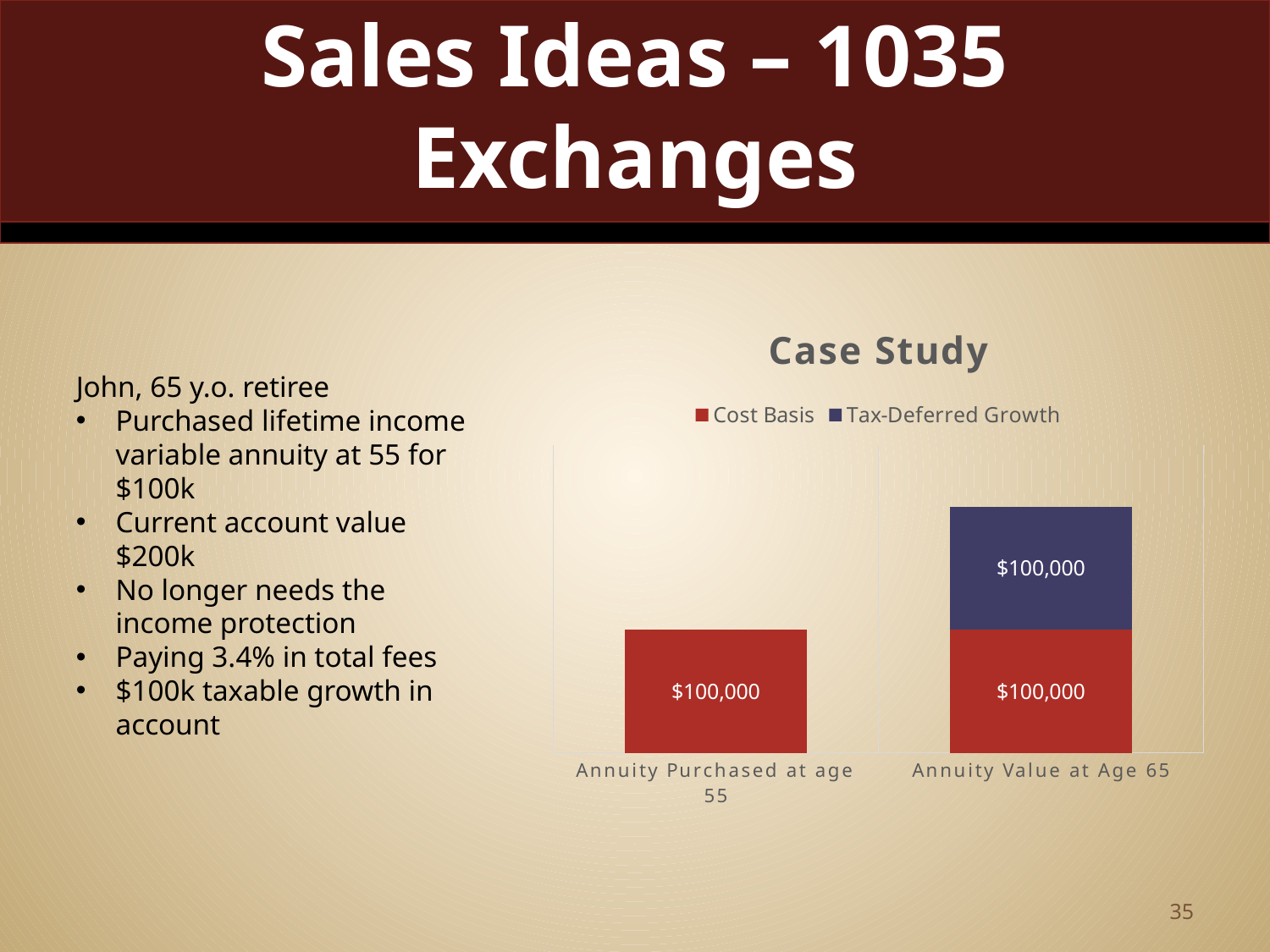
How many categories are shown on the x axis of the chart? 2 What is the total of the stacked bar for Annuity Value at Age 65? $200,000 What is the title of the chart? Case Study How many series does the legend list? 2 What is the total of the stacked bar for Annuity Purchased at age 55? $100,000 What is the Cost Basis value for Annuity Value at Age 65? $100,000 What is the Tax-Deferred Growth value for Annuity Value at Age 65? $100,000 What kind of chart is shown on the slide? Stacked bar chart Which category has the lower total bar value? Annuity Purchased at age 55 What is the Cost Basis value for Annuity Purchased at age 55? $100,000 Which category has the higher total bar value? Annuity Value at Age 65 What is the difference between the total for Annuity Value at Age 65 and the total for Annuity Purchased at age 55? $100,000